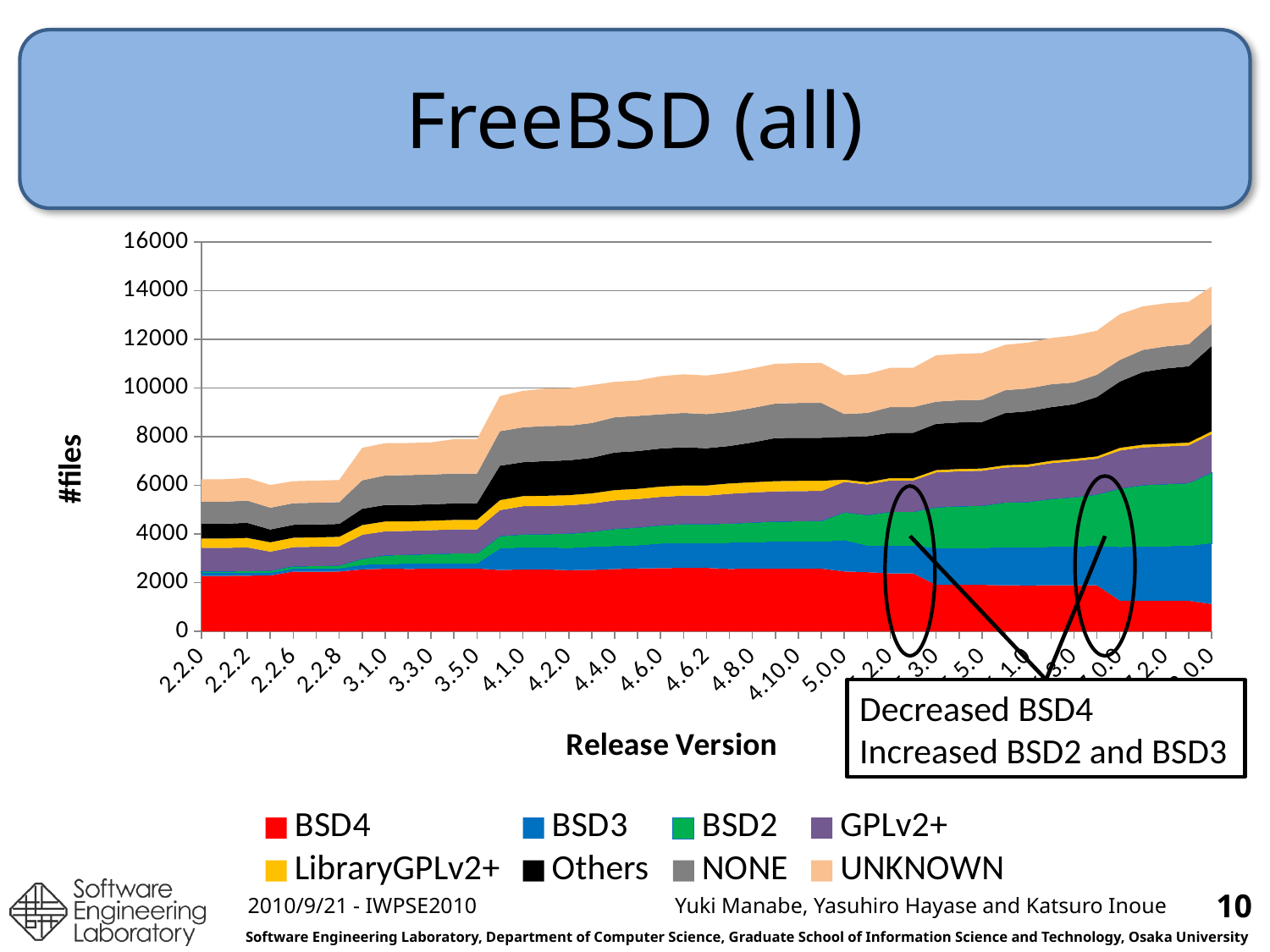
Which series is larger at release 2.2.0, BSD4 or BSD2? BSD4 Is the value for BSD4 at the last release on the x axis greater or less than 2000? less What is the title of the chart? FreeBSD (all) What kind of chart is shown on the slide? stacked area chart Is the total number of files at release 2.2.0 greater or less than 8000? less Is the total number of files at the last release on the x axis greater or less than 12000? greater Does the total number of files rise or fall from release 2.2.0 to the last release on the x axis? rise What is the label of the vertical axis? #files How many series does the legend list? 8 Does the BSD4 area rise or fall over the later releases (from 5.0.0 onward)? fall